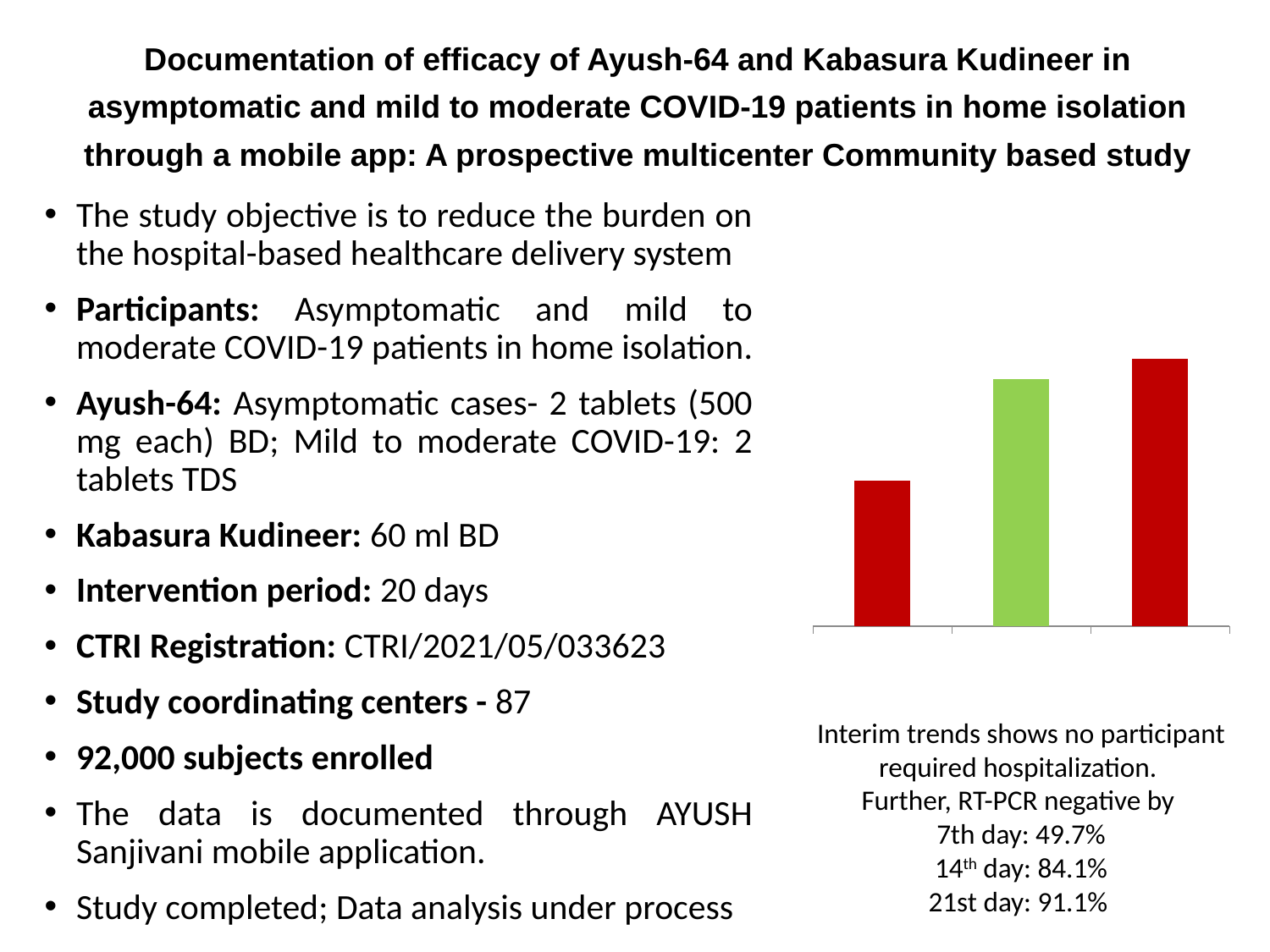
What kind of chart is shown on the right side of the slide? bar chart Which bar in the chart is the shortest: the leftmost, the middle, or the rightmost? leftmost Which bar in the chart is the tallest: the leftmost, the middle, or the rightmost? rightmost In the chart, is the leftmost bar or the middle bar taller? middle bar What colour are the leftmost and rightmost bars in the chart? red Do the bar heights in the chart rise or fall from left to right? rise What colour is the middle bar in the chart? green How many bars does the chart on the slide contain? 3